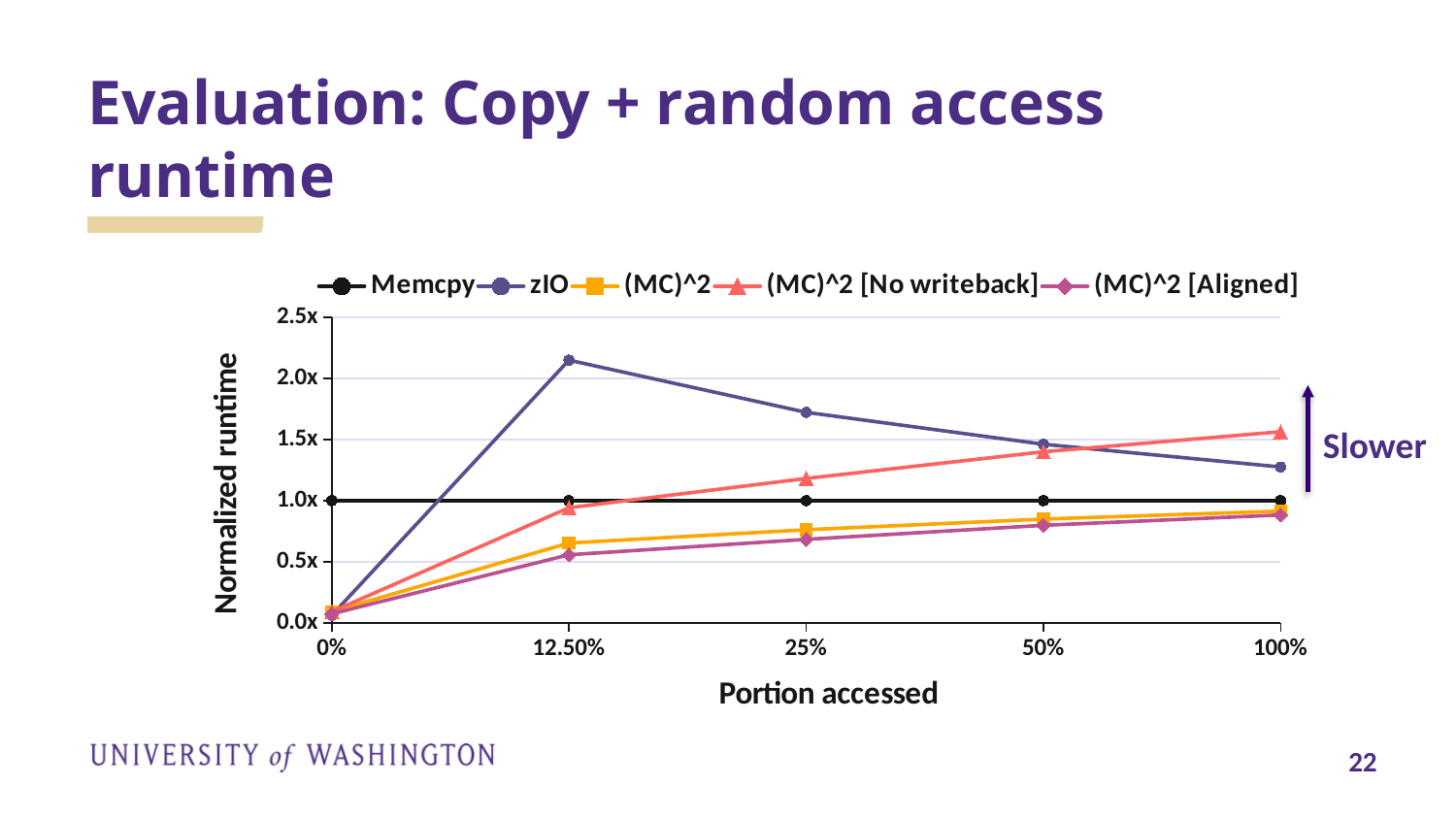
What is the normalized runtime for Memcpy at 50% portion accessed? 1.0x Which series has the lowest normalized runtime at 12.50% portion accessed? (MC)^2 [Aligned] Which series has the highest normalized runtime at 12.50% portion accessed? zIO What is the title of the y axis? Normalized runtime Is the normalized runtime for (MC)^2 at 25% greater or less than 1.0x? less Which series has the highest normalized runtime at 100% portion accessed? (MC)^2 [No writeback] How many portion-accessed categories are shown on the x axis? 5 What kind of chart is shown on the slide? line chart How many series does the legend list? 5 At 100% portion accessed, which is larger: the normalized runtime for zIO or for (MC)^2 [Aligned]? zIO Is the normalized runtime for zIO at 12.50% greater or less than 2.0x? greater Does the normalized runtime for zIO rise or fall from 12.50% to 100% portion accessed? fall